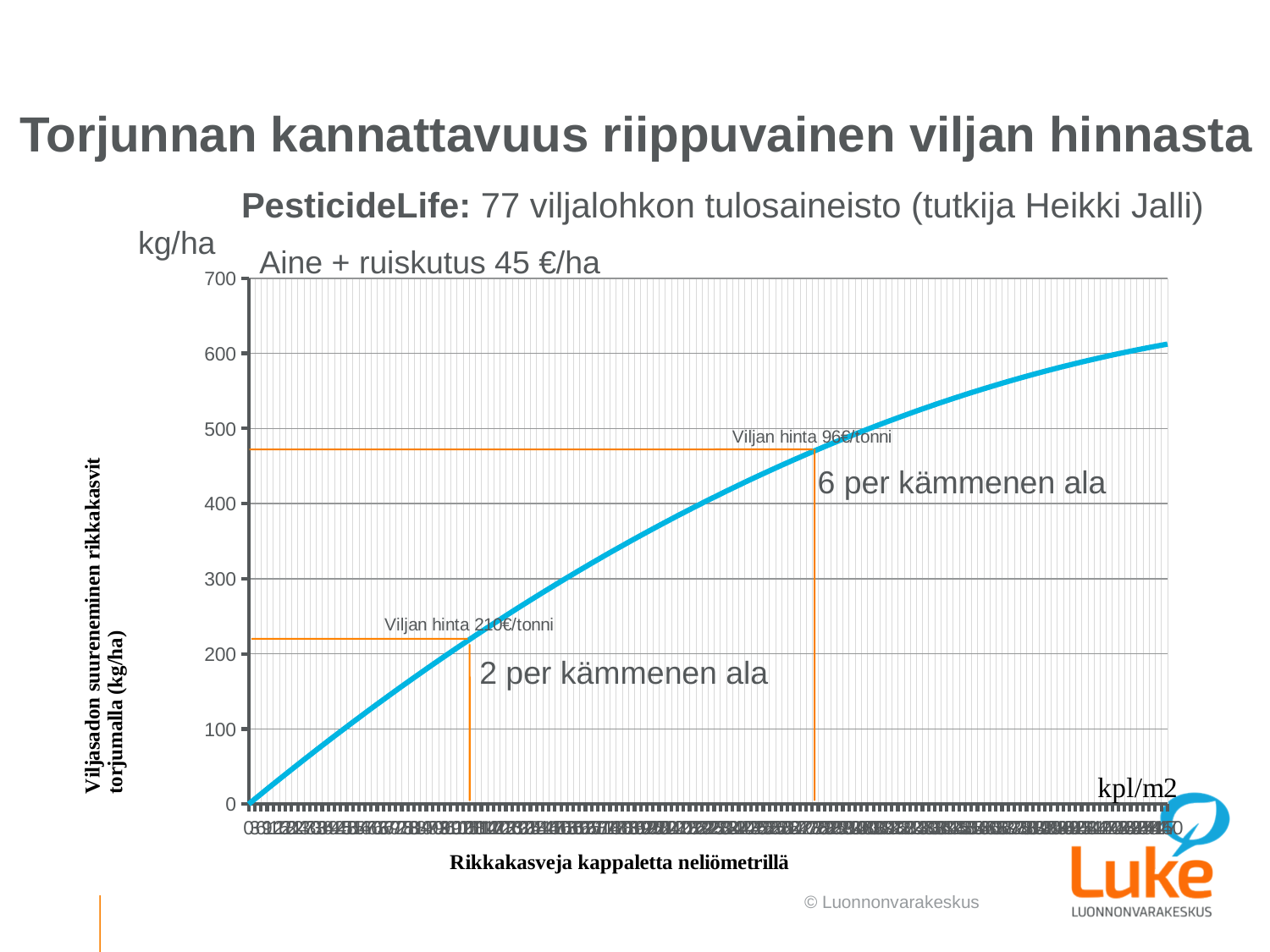
At the point marked 'Viljan hinta 96€/tonni', is the value of the line greater or less than 400? greater Is the value of the line at the right-hand end of the chart greater or less than 700? less Which grain price is marked at the point labelled '2 per kämmenen ala'? 210€/tonni Is the value of the line at the right-hand end of the chart greater or less than 500? greater What is the highest tick value shown on the y axis? 700 How many lines are plotted on the chart? 1 Does the plotted line rise or fall as the number of weeds per square metre increases along the x axis? rise Which of the two marked points has the higher value: 'Viljan hinta 96€/tonni' or 'Viljan hinta 210€/tonni'? Viljan hinta 96€/tonni What kind of chart is shown on the slide? line chart What is the title of the chart? Aine + ruiskutus 45 €/ha What unit is shown at the top of the y axis? kg/ha